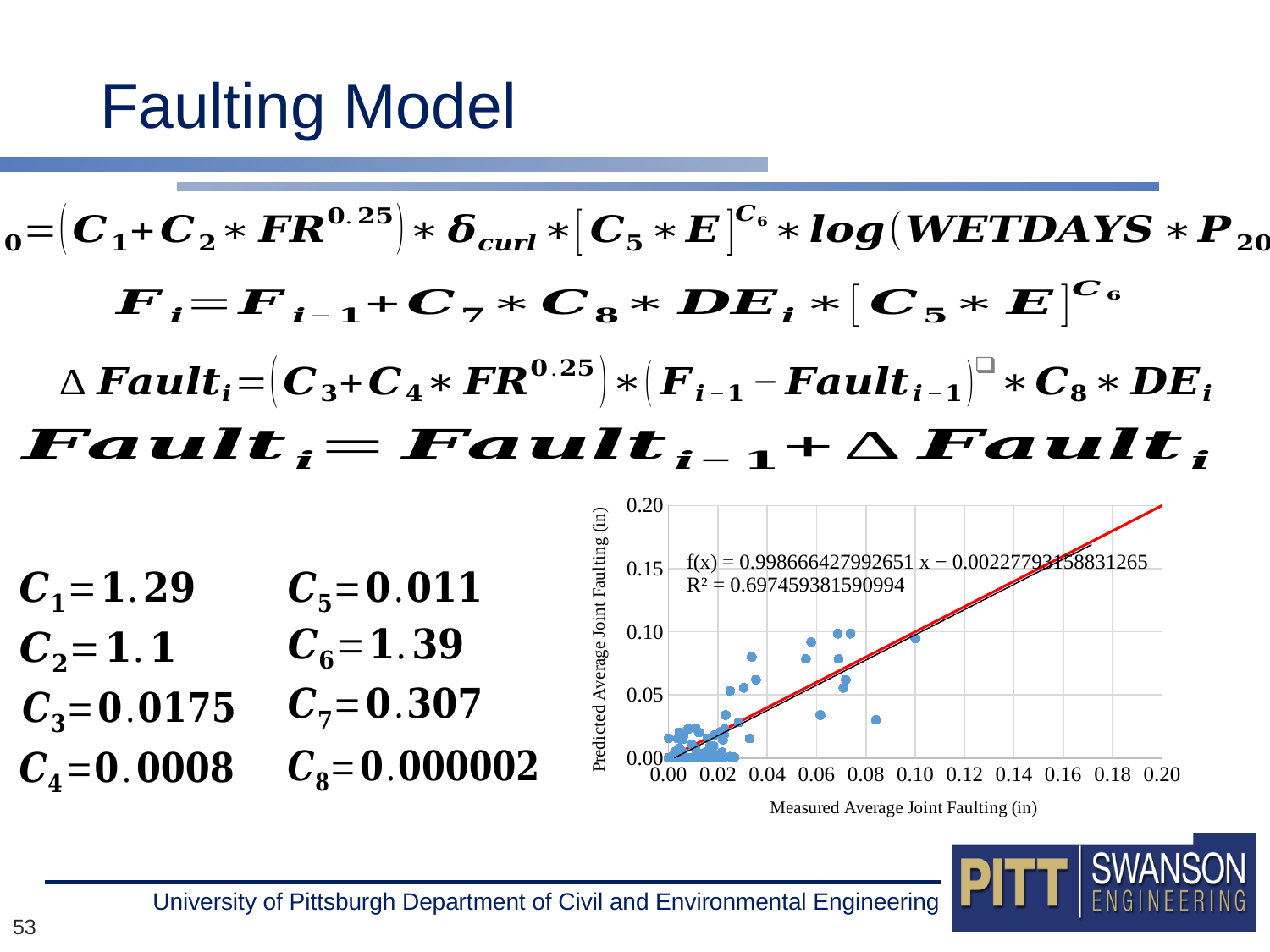
What R² value is printed on the chart? 0.697459381590994 What is the title of the y axis of the chart? Predicted Average Joint Faulting (in) What is the highest value shown on the y axis of the chart? 0.20 What kind of chart is shown on the slide? Scatter chart What is the highest value shown on the x axis of the chart? 0.20 What is the slope (coefficient of x) in the trendline equation printed on the chart? 0.998666427992651 What is the title of the x axis of the chart? Measured Average Joint Faulting (in) Is the largest measured faulting value among the plotted data points greater or less than 0.12? less Do the predicted faulting values generally rise or fall as measured faulting increases along the x axis? Rise Is the predicted faulting value for the isolated data point near 0.085 on the x axis greater or less than 0.05? less Is the predicted faulting value for the data point with the largest measured faulting (near 0.10 on the x axis) greater or less than 0.15? less